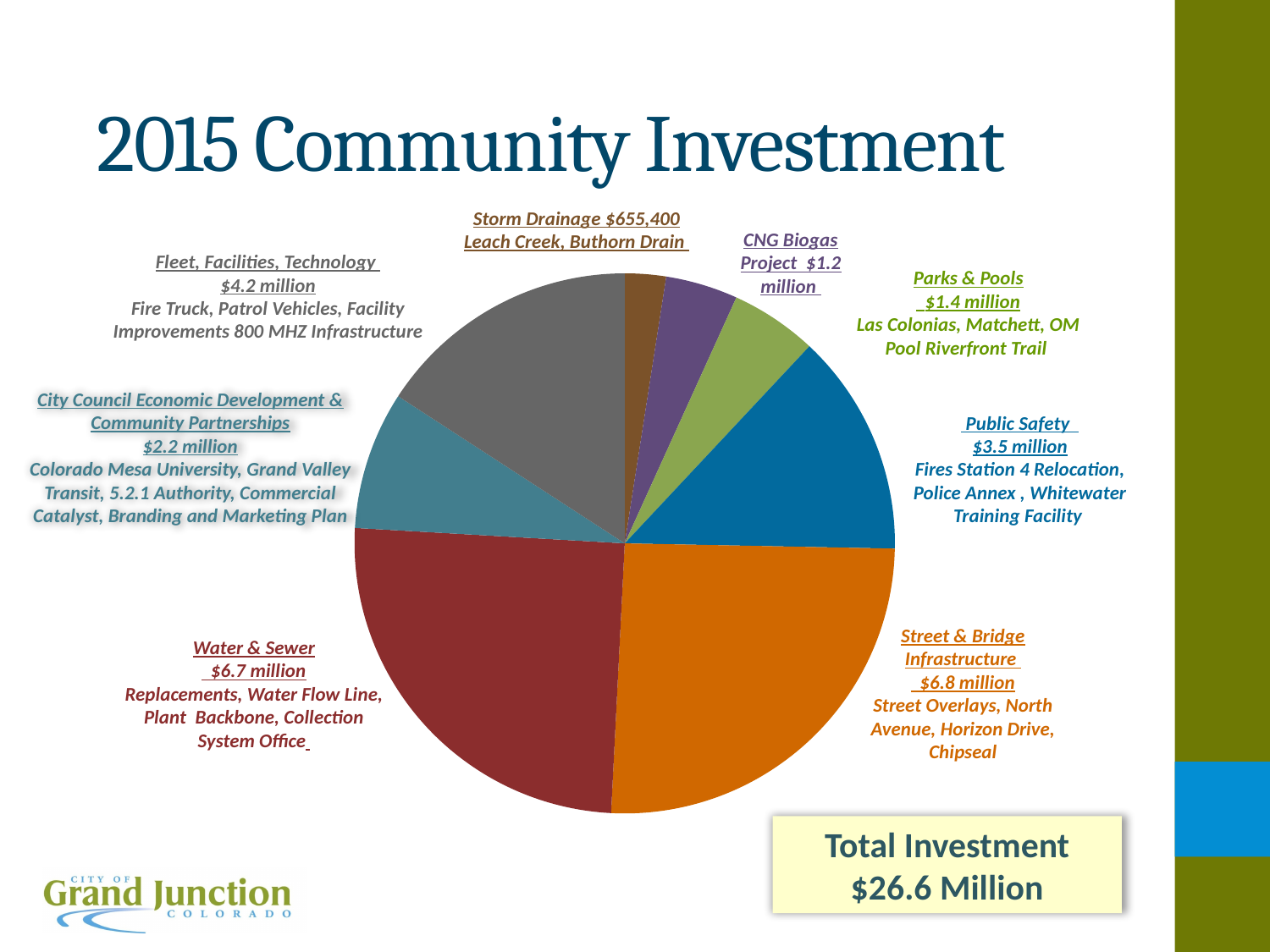
What is the investment amount for the CNG Biogas Project? $1.2 million What is the investment amount for Storm Drainage? $655,400 What is the investment amount for Street & Bridge Infrastructure? $6.8 million Which is larger, the investment for Fleet, Facilities, Technology or for Public Safety? Fleet, Facilities, Technology What is the investment amount for Public Safety? $3.5 million What kind of chart is shown on the slide? pie chart What total investment is stated on the slide? $26.6 Million What is the difference between the Fleet, Facilities, Technology investment and the Public Safety investment? $0.7 million What is the title of the slide's chart? 2015 Community Investment How many slices does the pie chart have? 8 What is the investment amount for Water & Sewer? $6.7 million Which category has the smallest slice of the pie? Storm Drainage